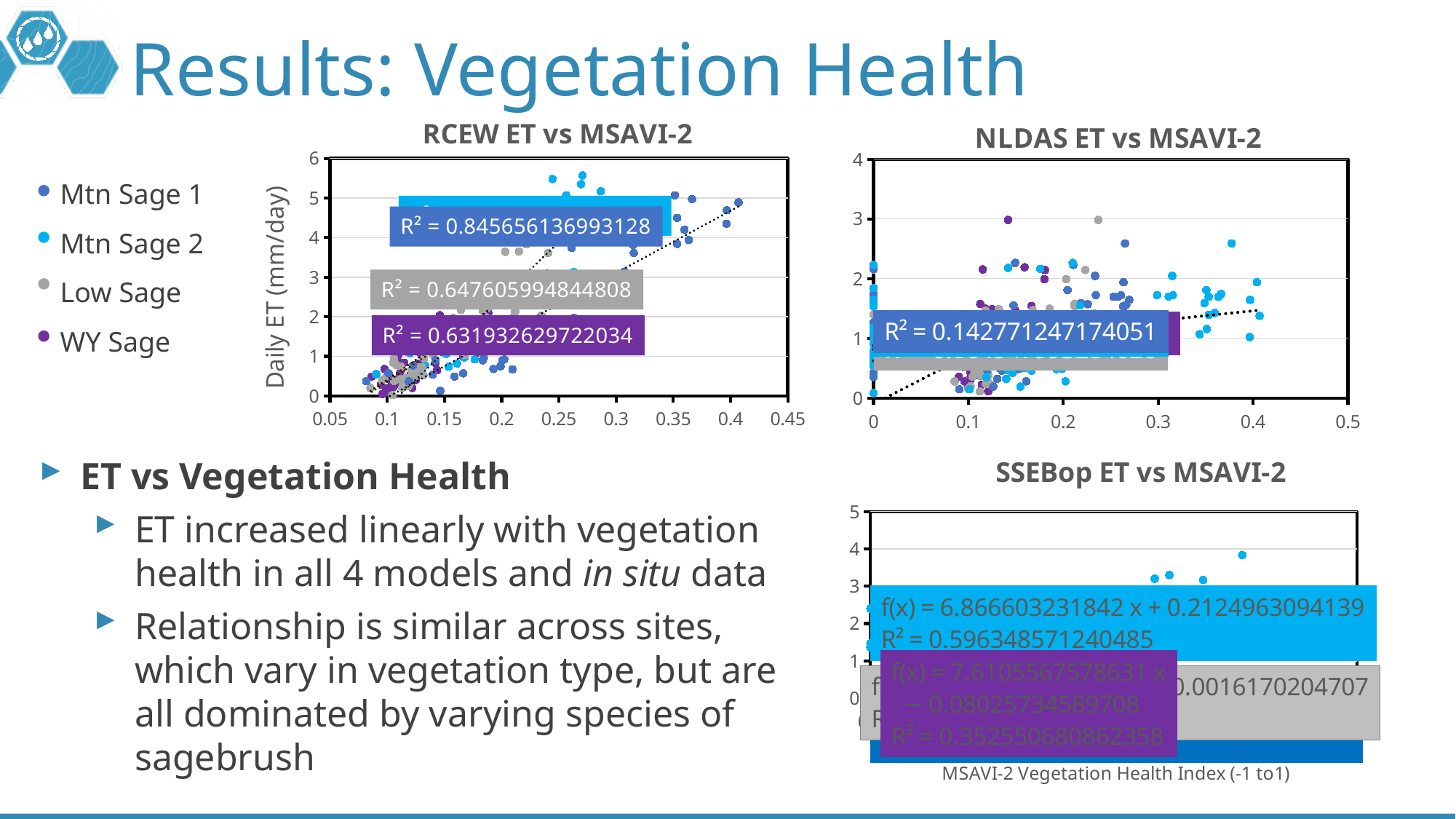
How many series does the legend list for the charts on this slide? 4 What kind of chart is the 'RCEW ET vs MSAVI-2' chart? scatter chart In the 'RCEW ET vs MSAVI-2' chart, what R² value is shown in the purple label box? R² = 0.631932629722034 What is the title of the chart in the top right of the slide? NLDAS ET vs MSAVI-2 In the 'RCEW ET vs MSAVI-2' chart, what R² value is shown in the blue label box? R² = 0.845656136993128 What is the y-axis label of the 'RCEW ET vs MSAVI-2' chart? Daily ET (mm/day) In the 'NLDAS ET vs MSAVI-2' chart, what R² value is shown in the blue label box? R² = 0.142771247174051 In the 'RCEW ET vs MSAVI-2' chart, do the Daily ET values generally rise or fall as MSAVI-2 increases along the x axis? rise In the 'SSEBop ET vs MSAVI-2' chart, what R² value is shown in the light blue label box? R² = 0.596348571240485 In the 'RCEW ET vs MSAVI-2' chart, which label box shows the highest R² value: blue, grey or purple? blue In the 'RCEW ET vs MSAVI-2' chart, what R² value is shown in the grey label box? R² = 0.647605994844808 Is the R² value in the blue box of the 'RCEW ET vs MSAVI-2' chart larger or smaller than the R² value in the blue box of the 'NLDAS ET vs MSAVI-2' chart? larger